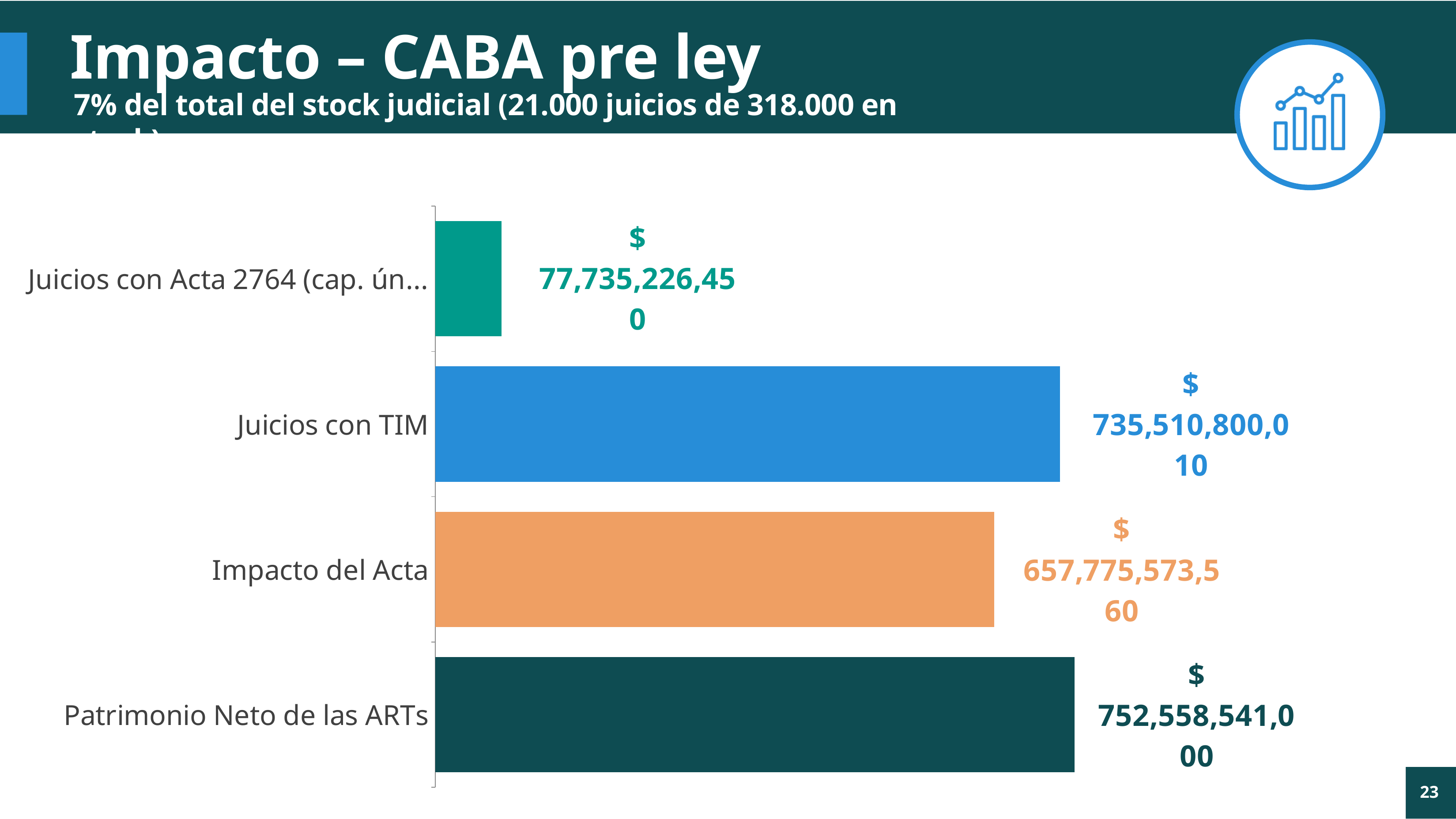
What is the title of the slide? Impacto – CABA pre ley What is the value for Juicios con TIM? $ 735,510,800,010 Which category has the highest value? Patrimonio Neto de las ARTs What kind of chart is shown on the slide? Bar chart What is the value for Juicios con Acta 2764? $ 77,735,226,450 What is the difference between Juicios con TIM and Impacto del Acta? $ 77,735,226,450 What is the value for Patrimonio Neto de las ARTs? $ 752,558,541,000 Which category has the lowest value? Juicios con Acta 2764 What is the value for Impacto del Acta? $ 657,775,573,560 How many categories are shown in the chart? 4 Which is larger, Juicios con TIM or Impacto del Acta? Juicios con TIM What is the difference between Patrimonio Neto de las ARTs and Juicios con TIM? $ 17,047,740,990